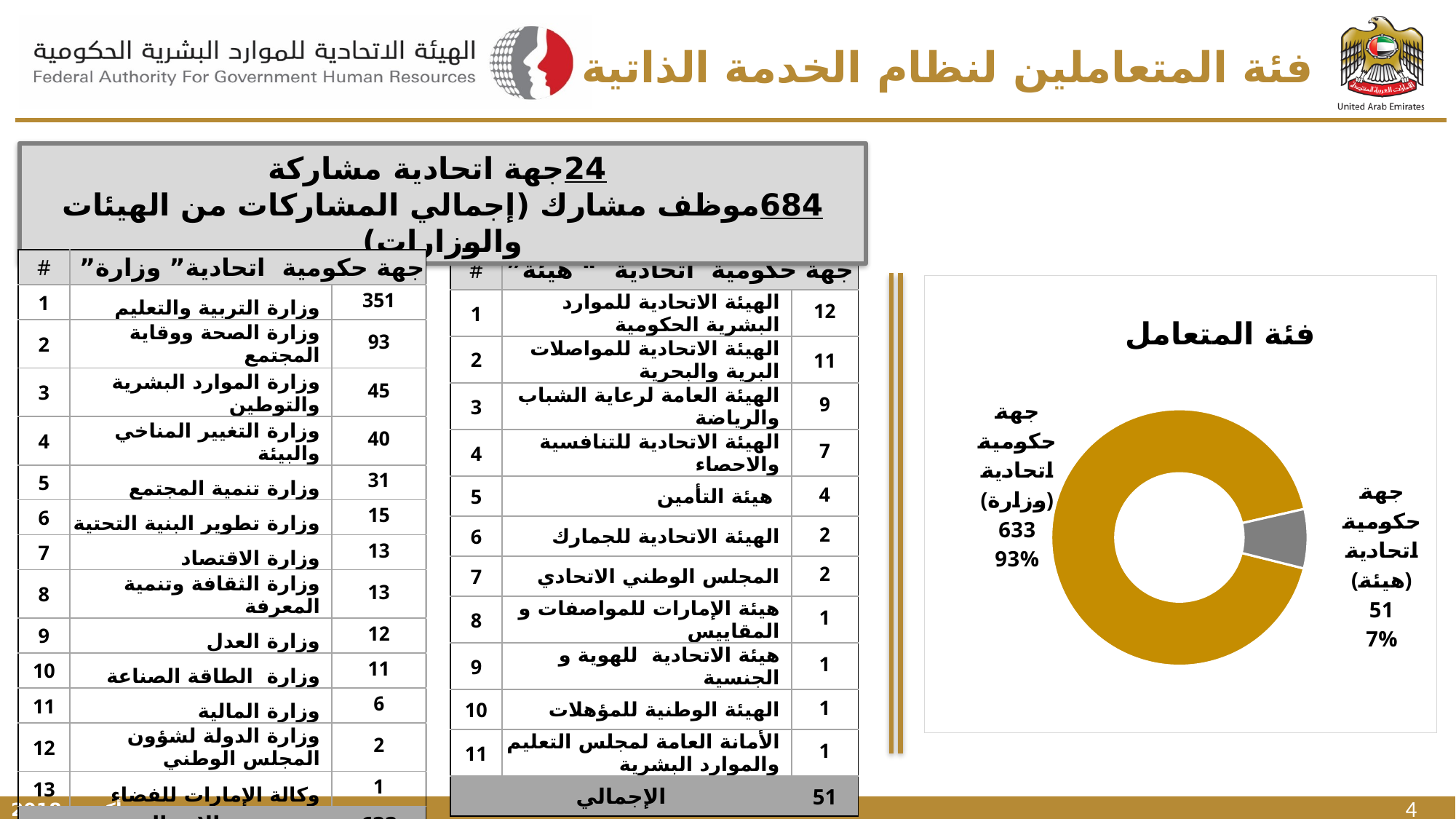
What is the value for جهة حكومية اتحادية (هيئة) in the chart? 51 Which category has the largest slice in the chart? جهة حكومية اتحادية (وزارة) What colour is the slice for جهة حكومية اتحادية (هيئة) in the chart? grey How many slices does the chart have? 2 Which category has the smallest slice in the chart? جهة حكومية اتحادية (هيئة) What is the value for جهة حكومية اتحادية (وزارة) in the chart? 633 What share of the chart does جهة حكومية اتحادية (وزارة) represent? 93% What type of chart is shown on the slide? doughnut chart Which is larger in the chart: جهة حكومية اتحادية (وزارة) or جهة حكومية اتحادية (هيئة)? جهة حكومية اتحادية (وزارة) What share of the chart does جهة حكومية اتحادية (هيئة) represent? 7% What is the difference between the values for جهة حكومية اتحادية (وزارة) and جهة حكومية اتحادية (هيئة)? 582 What is the title of the chart on the slide? فئة المتعامل